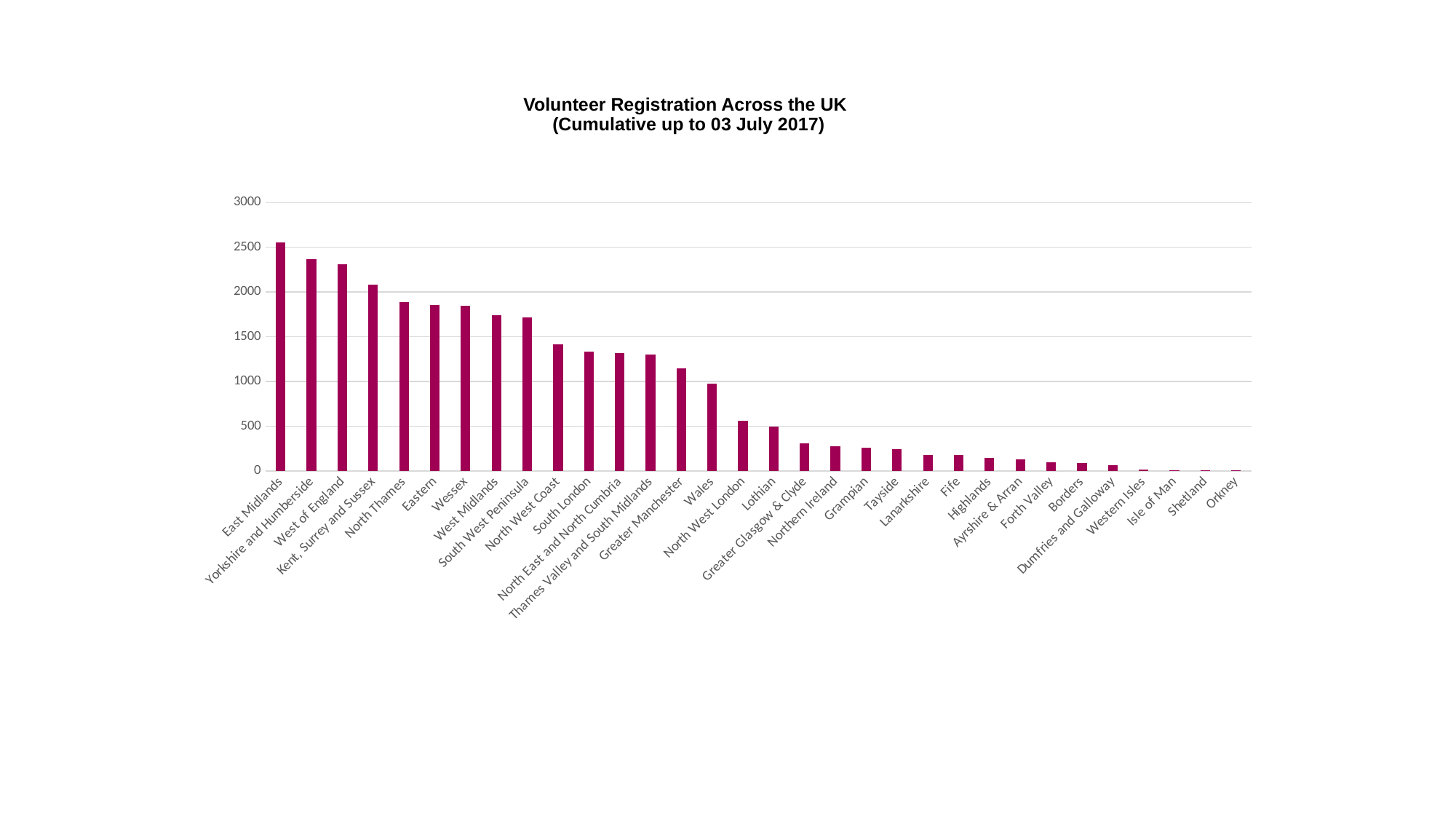
Is the value for North Thames greater or less than 2000? less What kind of chart is shown on the slide? bar chart Which region has the highest volunteer registration? East Midlands Is the value for Greater Manchester greater or less than 1000? greater Do the values rise or fall moving from left to right along the x axis? fall Is the value for West of England greater or less than 2000? greater Which has the larger value, Wales or North West London? Wales What is the title of the chart? Volunteer Registration Across the UK (Cumulative up to 03 July 2017) How many regions are plotted on the chart? 32